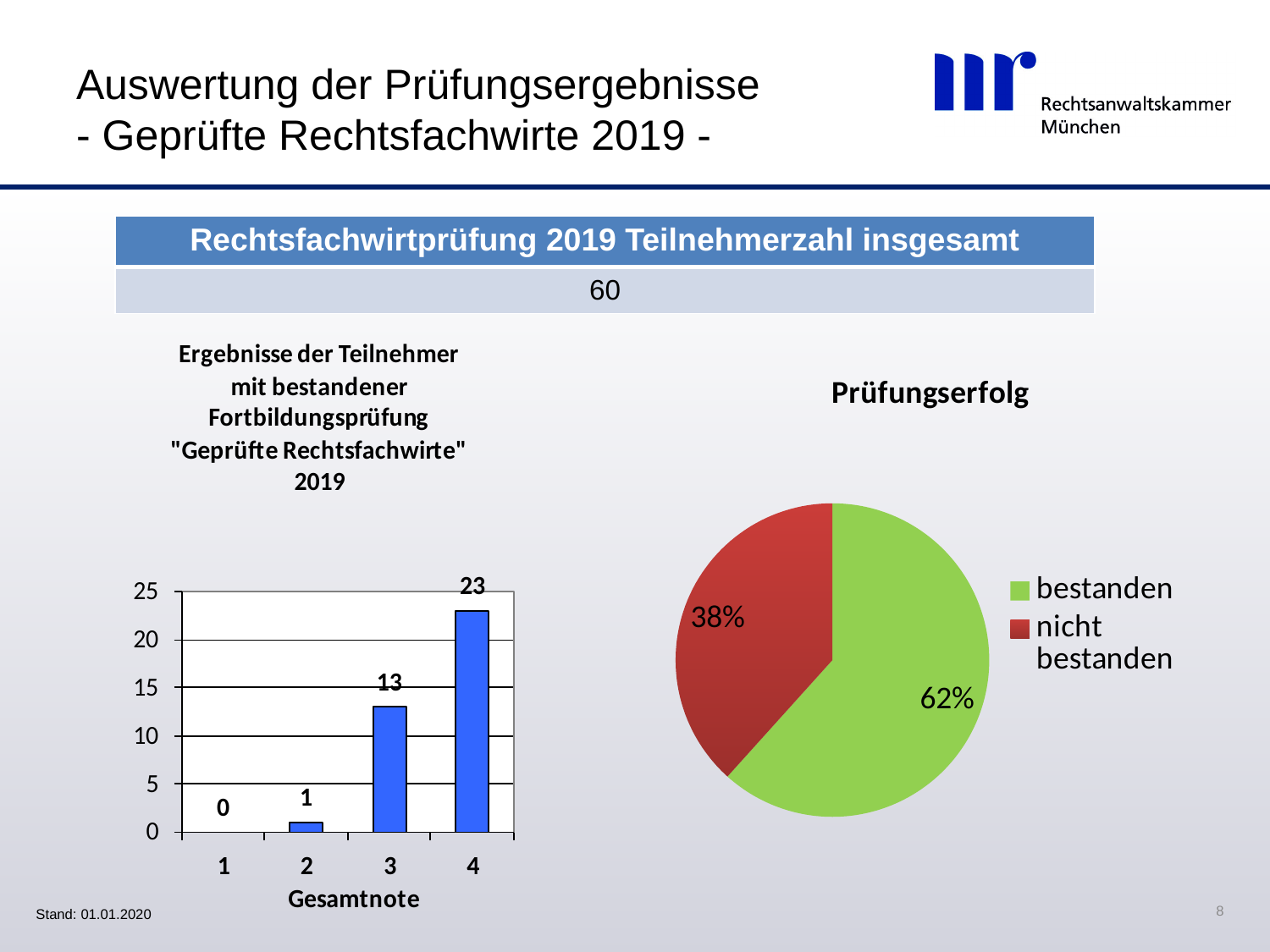
In the bar chart on the left, which Gesamtnote has the lowest number of participants? 1 In the bar chart on the left, how many participants received a Gesamtnote of 3? 13 In the bar chart on the left, which Gesamtnote has the highest number of participants? 4 In the bar chart on the left, what is the value for Gesamtnote 1? 0 In the Prüfungserfolg chart on the right, what share of participants is labelled nicht bestanden? 38% In the bar chart on the left, do the values rise or fall as the Gesamtnote increases from 1 to 4? rise In the bar chart on the left, what is the difference between the values for Gesamtnote 4 and Gesamtnote 3? 10 In the bar chart on the left, how many participants received a Gesamtnote of 4? 23 In the bar chart on the left, which is larger: the value for Gesamtnote 2 or Gesamtnote 3? Gesamtnote 3 In the Prüfungserfolg chart on the right, what share of participants is labelled bestanden? 62% In the bar chart on the left, how many Gesamtnote categories are shown on the x axis? 4 What kind of chart is the Prüfungserfolg chart on the right? pie chart